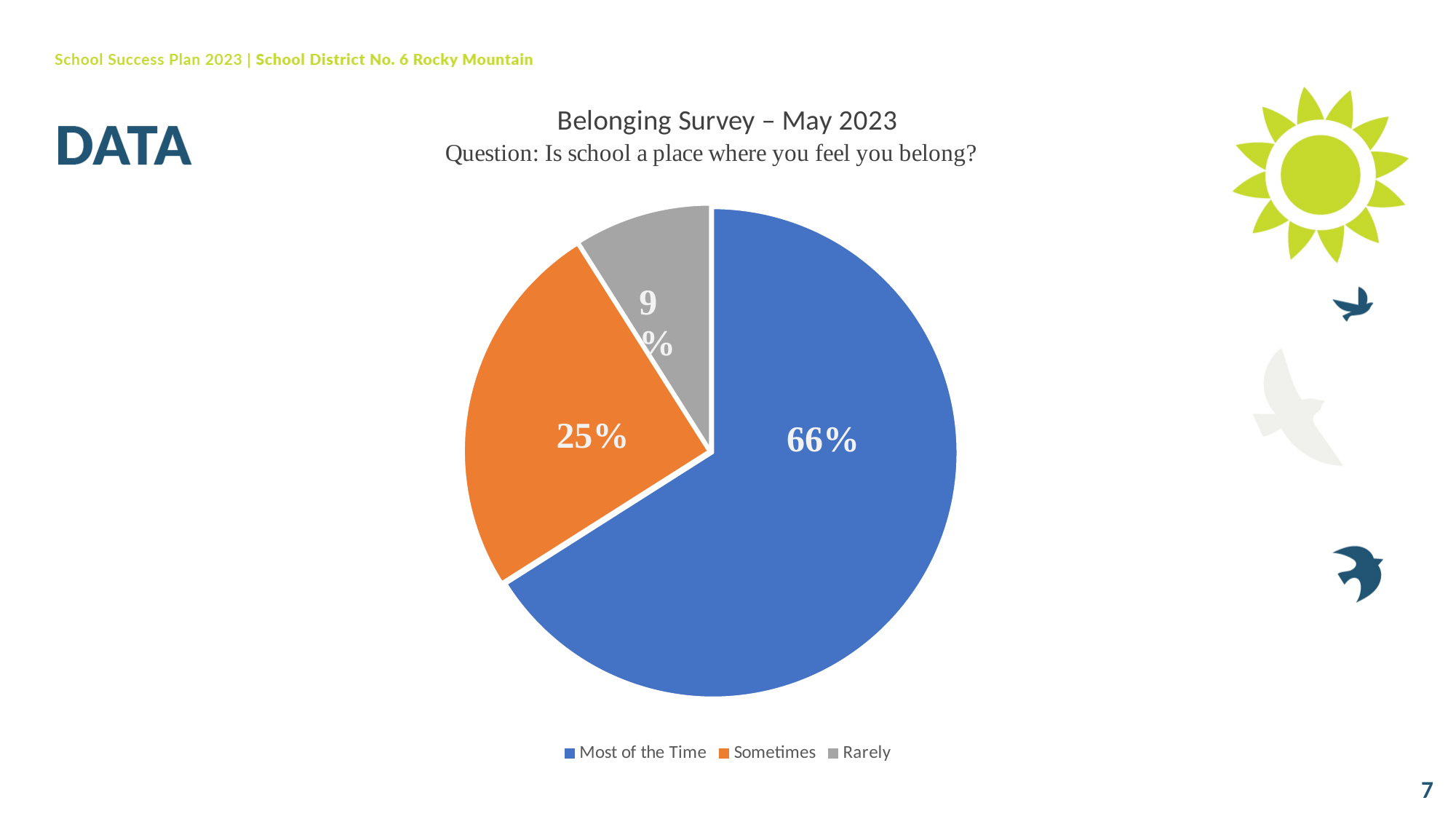
Which response has the smallest share of the pie? Rarely What percentage of respondents answered "Sometimes"? 25% What is the difference in percentage points between "Most of the Time" and "Sometimes"? 41 What colour is the "Sometimes" slice? orange What percentage of respondents answered "Rarely"? 9% Which response has the largest share of the pie? Most of the Time What percentage of respondents answered "Most of the Time"? 66% How many slices does the pie chart have? 3 What kind of chart is shown on the slide? pie chart What is the difference in percentage points between "Sometimes" and "Rarely"? 16 Which is larger, the share for "Sometimes" or the share for "Rarely"? Sometimes What is the title of the chart? Belonging Survey – May 2023